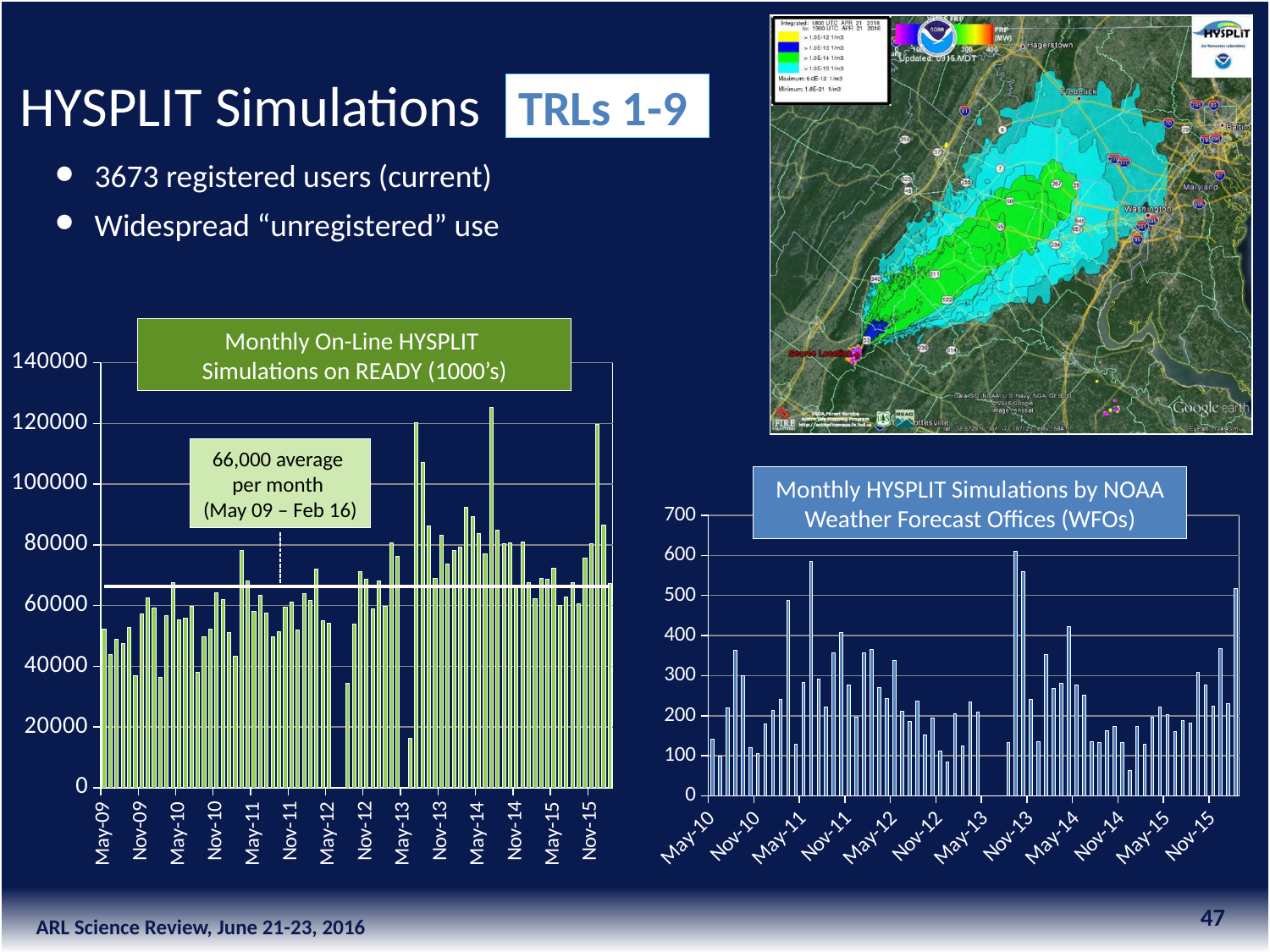
What kind of chart is the 'Monthly On-Line HYSPLIT Simulations on READY (1000's)' chart? bar chart In the 'Monthly On-Line HYSPLIT Simulations on READY' chart, is the value for May-09 greater or less than 60000? less In the 'Monthly On-Line HYSPLIT Simulations on READY' chart, is the highest bar greater or less than 120000? greater In the 'Monthly HYSPLIT Simulations by NOAA Weather Forecast Offices (WFOs)' chart, is the value for May-10 greater or less than 200? less In the 'Monthly On-Line HYSPLIT Simulations on READY' chart, what average per month is stated in the annotation for May 09 – Feb 16? 66,000 What kind of chart is the 'Monthly HYSPLIT Simulations by NOAA Weather Forecast Offices (WFOs)' chart? bar chart What is the title of the chart on the left of the slide? Monthly On-Line HYSPLIT Simulations on READY (1000's)